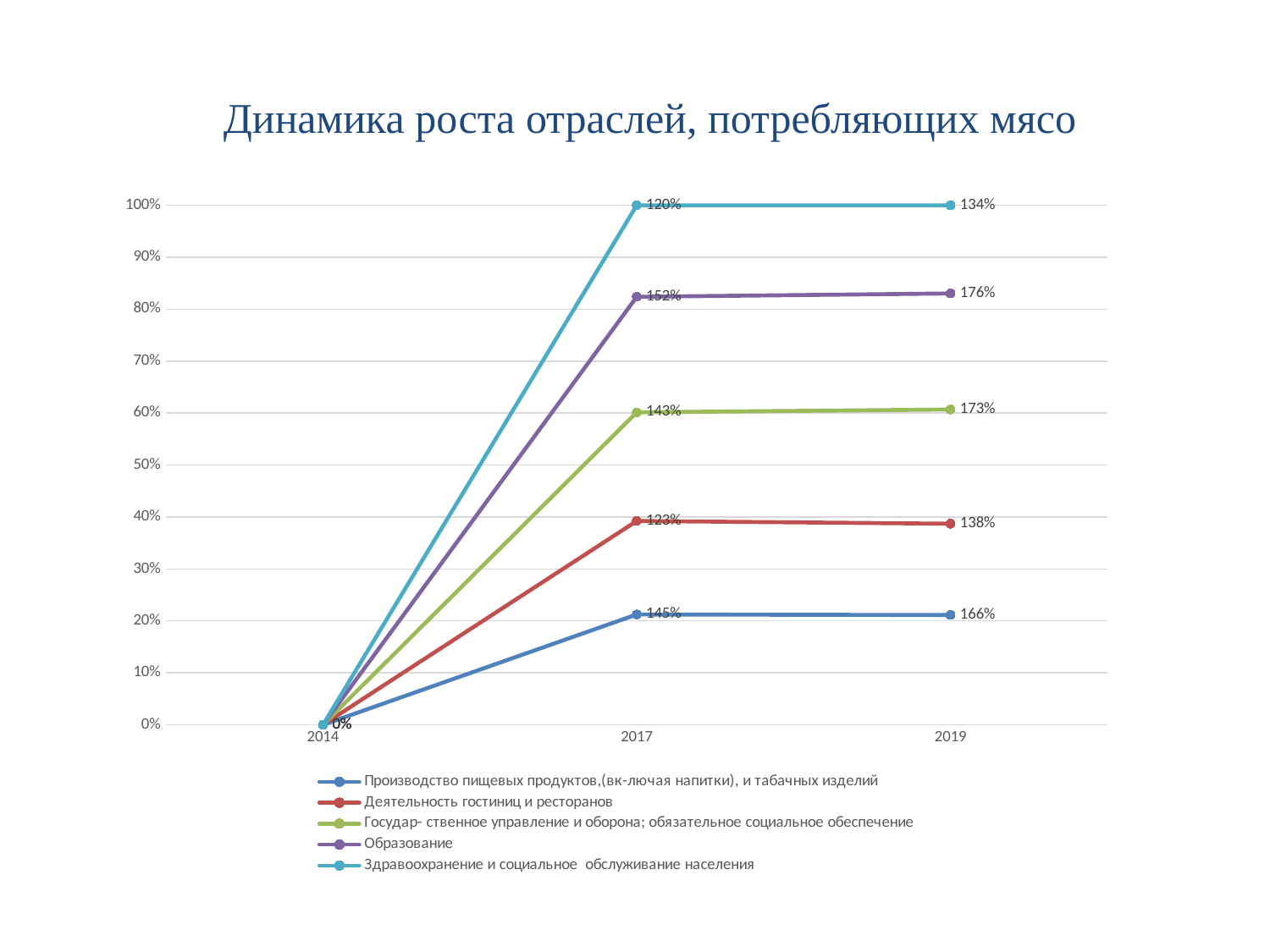
What is the data label for Здравоохранение и социальное обслуживание населения in 2017? 120% What is the data label for Государ- ственное управление и оборона; обязательное социальное обеспечение in 2019? 173% What is the data label for Производство пищевых продуктов,(вк-лючая напитки), и табачных изделий in 2017? 145% What is the title of the chart? Динамика роста отраслей, потребляющих мясо What is the data label for Деятельность гостиниц и ресторанов in 2019? 138% Do the labelled values for Деятельность гостиниц и ресторанов rise or fall from 2014 to 2019? rise How many years are shown on the x axis? 3 What type of chart is shown on the slide? line chart What is the data label for Образование in 2019? 176% What value is labelled for all series in 2014? 0% By how many percentage points does the Образование label change from 2017 to 2019? 24 percentage points How many series does the legend list? 5